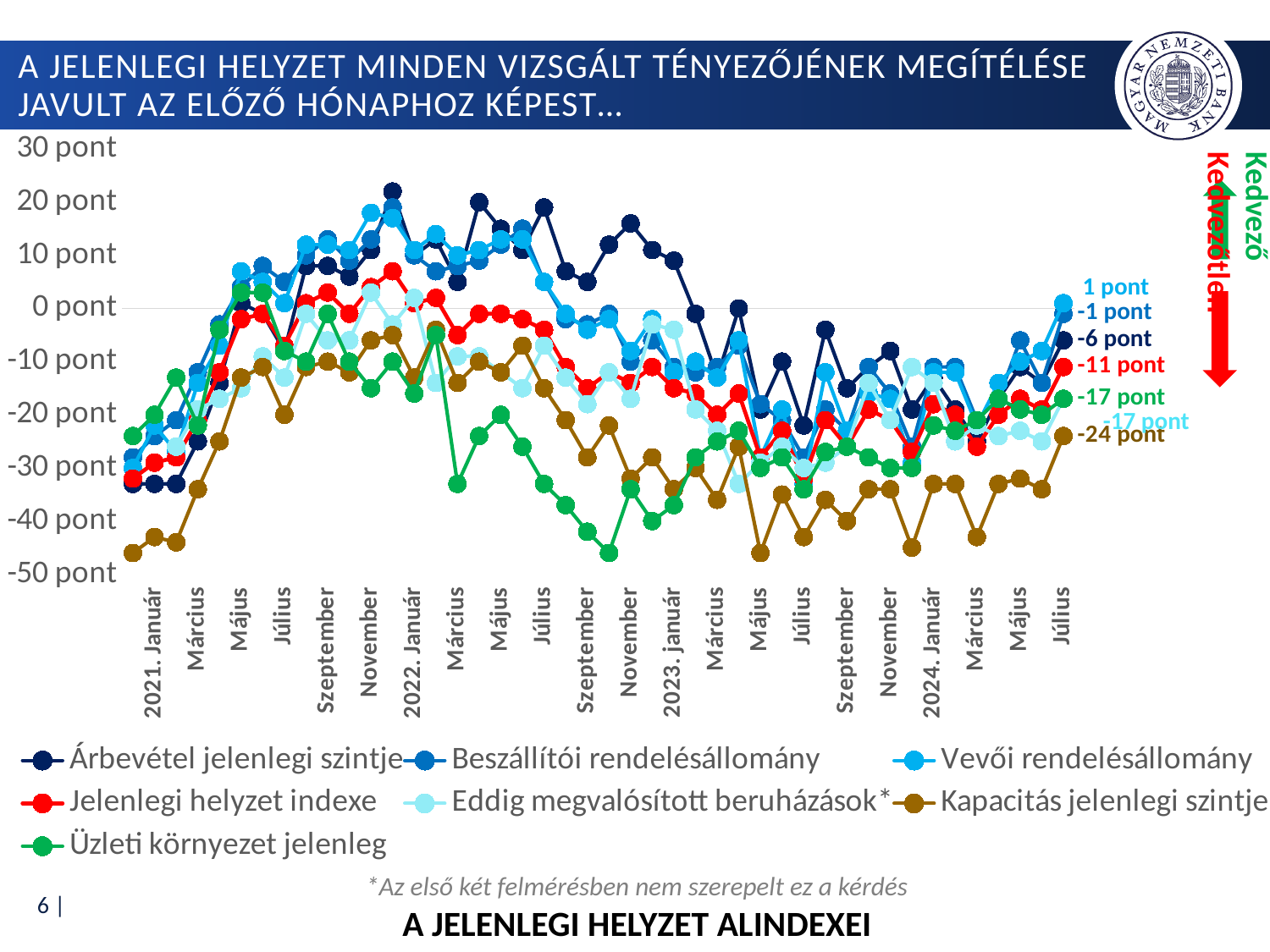
Which series has the lowest labelled value at the end of the chart? Kapacitás jelenlegi szintje What is the latest value labelled for Árbevétel jelenlegi szintje? -6 pont What is the latest value labelled for Kapacitás jelenlegi szintje? -24 pont Which series has the highest labelled value at the end of the chart? Vevői rendelésállomány What kind of chart is shown on the slide? line chart Does the Kapacitás jelenlegi szintje series rise or fall between 2021. Január and Július 2021? rise How many series does the legend list? 7 What is the latest value labelled for Jelenlegi helyzet indexe? -11 pont What is the latest value labelled for Beszállítói rendelésállomány? -1 pont What is the difference between the end-of-chart values of Vevői rendelésállomány (1 pont) and Kapacitás jelenlegi szintje (-24 pont)? 25 pont Is the value for Kapacitás jelenlegi szintje in 2021. Január greater or less than -40 pont? less What is the latest (Július 2024) value labelled for Vevői rendelésállomány? 1 pont